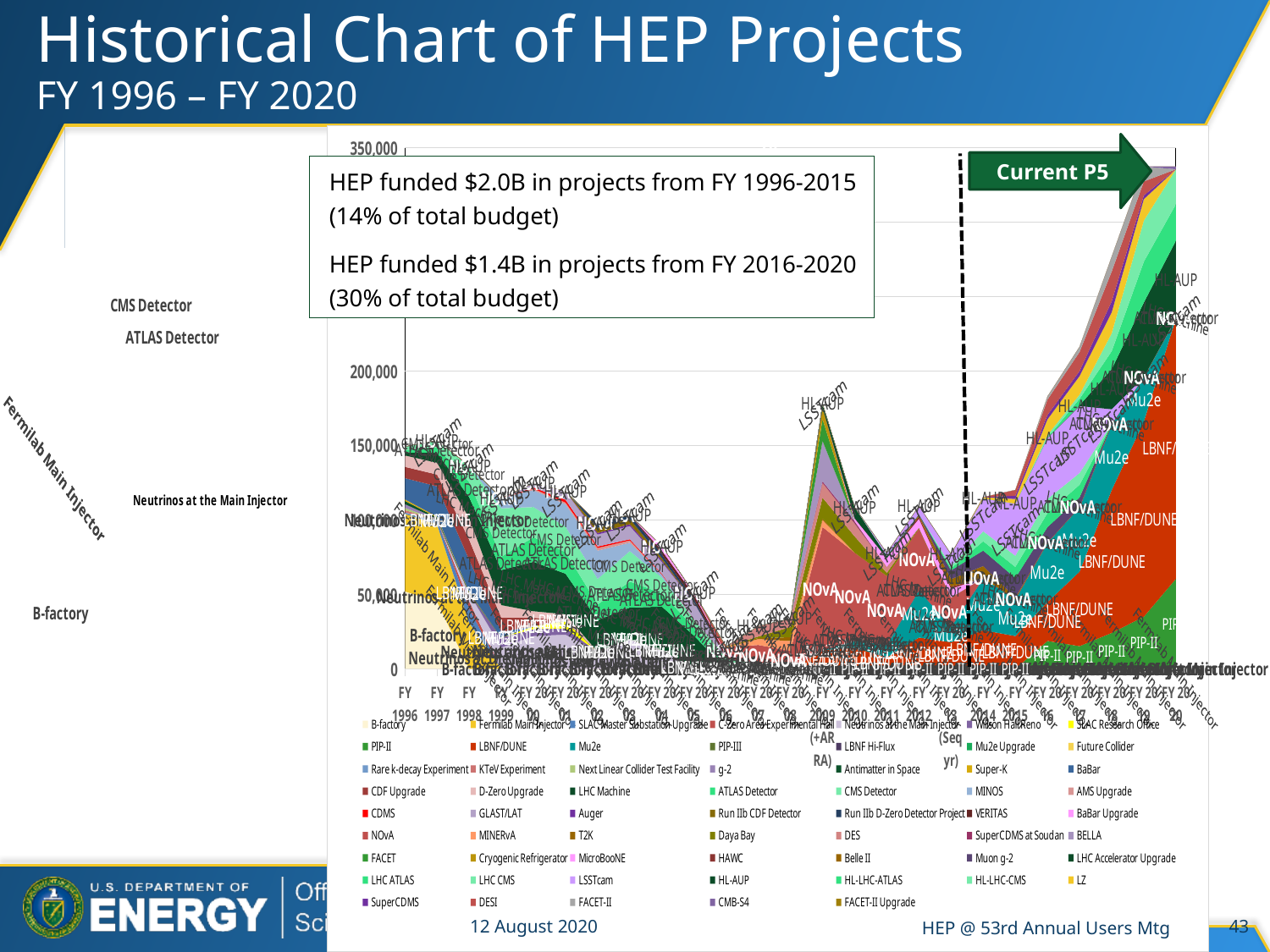
Do the total stacked values rise or fall from FY 1996 to FY 2006? fall Is the total stacked value for FY 2020 greater or less than 200,000? greater How many fiscal years does the x axis of the chart cover? 25 According to the text box on the chart, how much did HEP fund in projects from FY 1996-2015? $2.0B Is the total stacked value for FY 1996 greater or less than 100,000? greater Is the total stacked value for FY 2020 greater or less than 350,000? less What kind of chart is shown on the slide? stacked area chart Do the total stacked values rise or fall from FY 2014 to FY 2020? rise What is the title of the chart on the slide? Historical Chart of HEP Projects FY 1996 – FY 2020